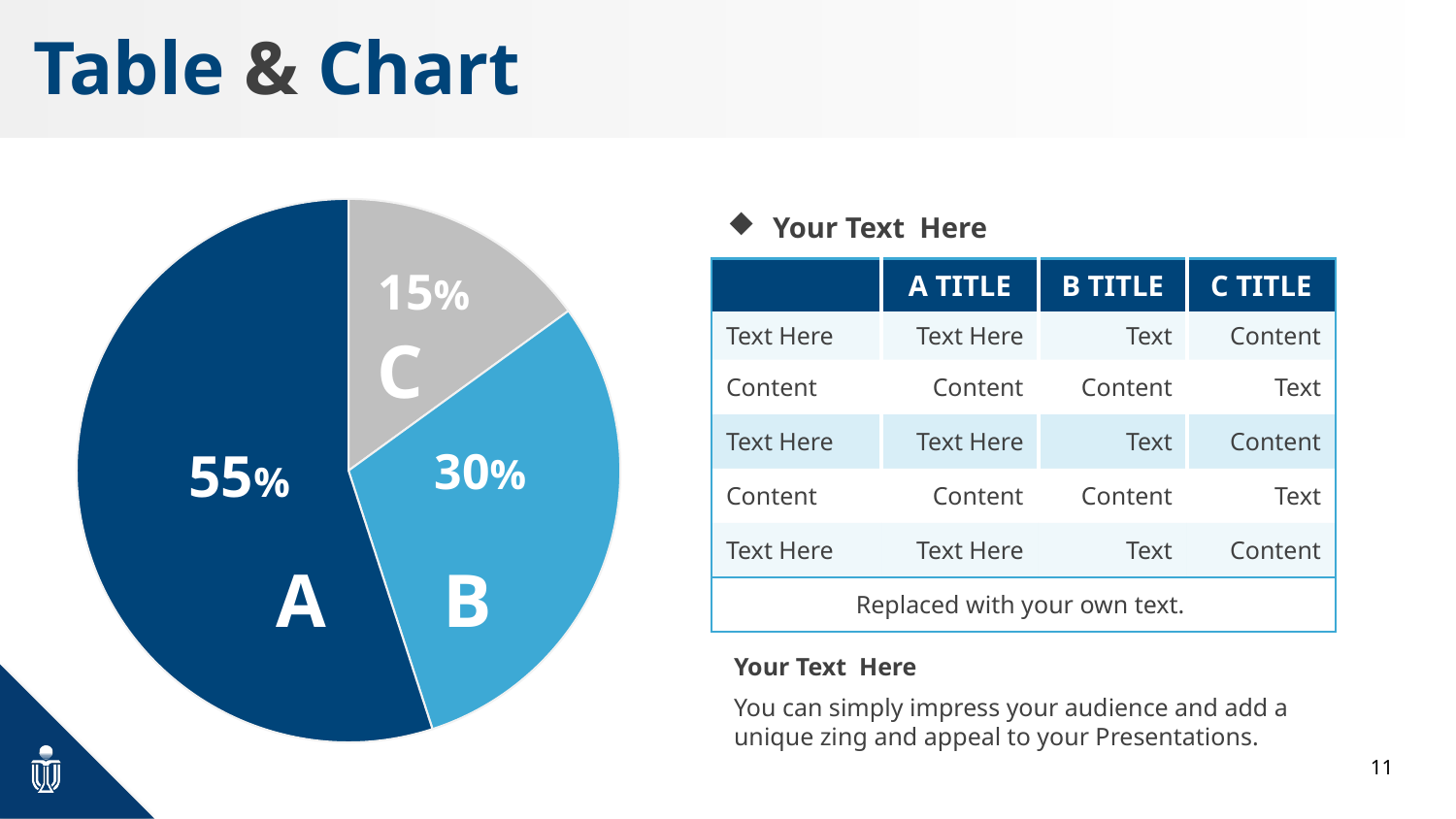
What percentage does slice C represent in the pie chart? 15% Which slice of the pie chart is the largest? A What is the difference in percentage points between slice B and slice C? 15 What colour is slice A in the pie chart? dark blue What is the difference in percentage points between slice A and slice B? 25 How many slices does the pie chart have? 3 What percentage does slice B represent in the pie chart? 30% What kind of chart is shown on the slide? pie chart What colour is slice C in the pie chart? grey Which is larger, slice B or slice C? B Which slice of the pie chart is the smallest? C What percentage does slice A represent in the pie chart? 55%